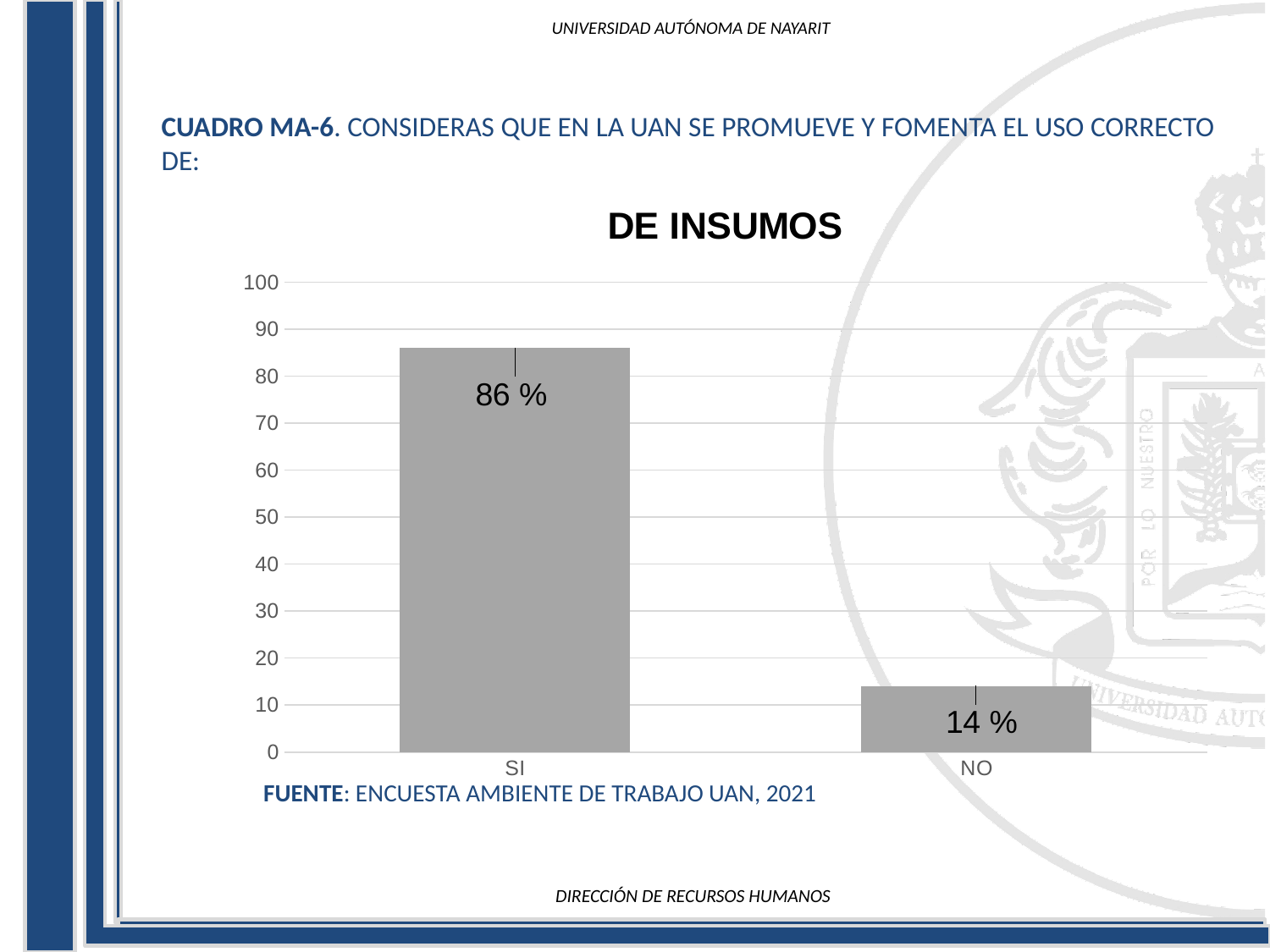
What is the difference between the values for SI and NO? 72 % What is the title of the chart? DE INSUMOS Which category has the highest value? SI How many categories are shown in the chart? 2 What is the value for NO? 14 % What is the value for SI? 86 % What kind of chart is shown? bar chart What is the maximum value shown on the vertical axis? 100 Is the value for NO greater or less than 20? less Which is larger, the value for SI or the value for NO? SI Is the value for SI greater or less than 80? greater Which category has the lowest value? NO